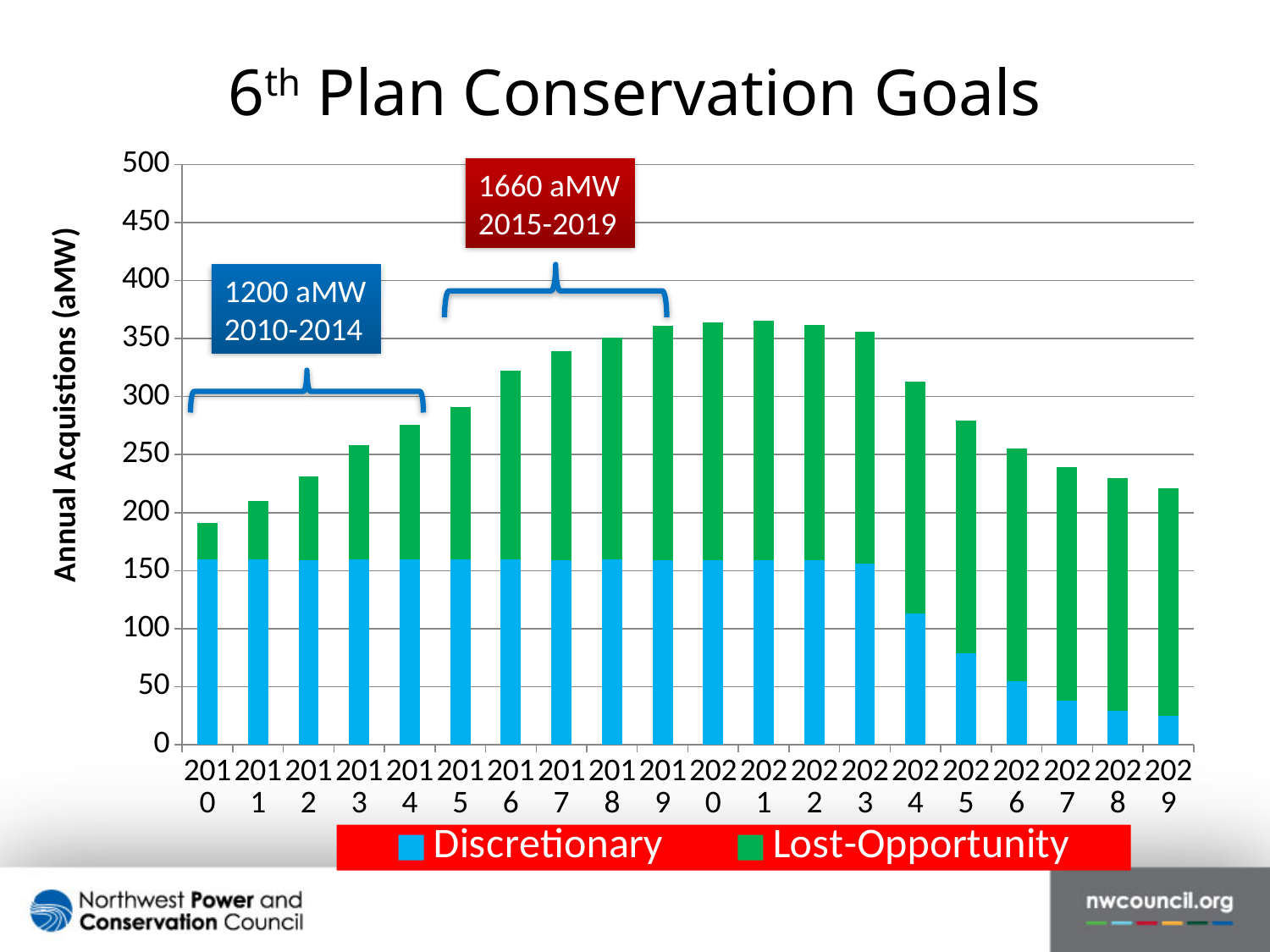
Is the Discretionary value for 2029 greater or less than 50? less Is the Discretionary value for 2015 greater or less than 150? greater How many years are plotted along the x axis? 20 Do the total values rise or fall from 2010 to 2019? rise According to the annotation on the chart, what is the conservation goal for 2015-2019? 1660 aMW Which year has the lowest total annual acquisitions? 2010 Do the total values rise or fall from 2023 to 2029? fall How many series does the legend list? 2 Which year has the larger total, 2010 or 2029? 2029 Is the total value for 2010 greater or less than 200? less What kind of chart is shown on the slide? stacked bar chart